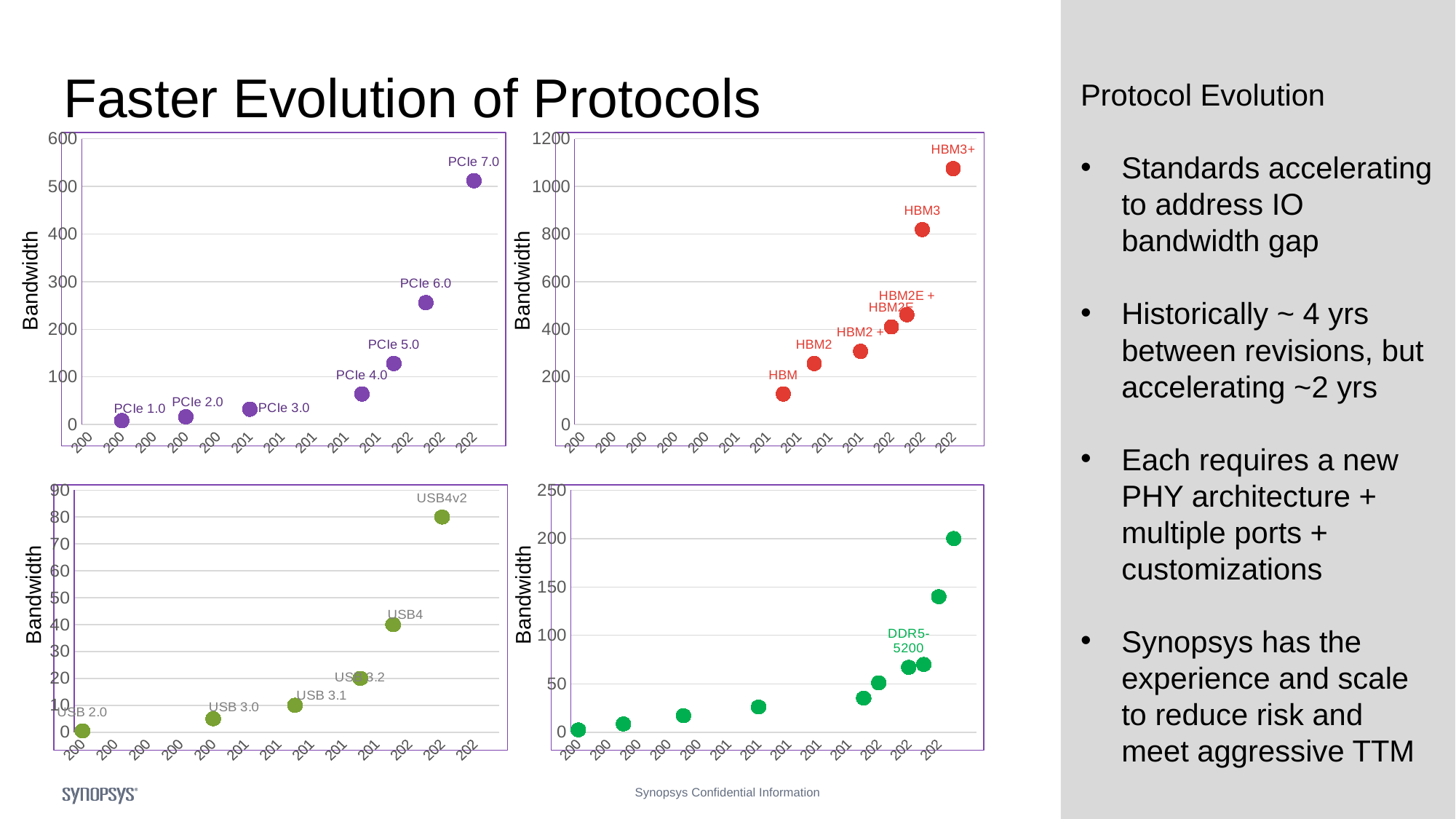
In the bottom-left USB chart, how many data points are plotted? 6 In the top-right HBM chart, is the value for HBM3+ greater or less than 1000? greater In the top-left PCIe chart, is the value for PCIe 4.0 greater or less than 100? less In the bottom-left USB chart, which is larger, the value for USB4 or the value for USB 3.2? USB4 In the top-right HBM chart, which labeled point has the lowest bandwidth? HBM In the top-left PCIe chart, is the value for PCIe 6.0 greater or less than 200? greater What kind of chart is the top-left chart (PCIe)? scatter chart In the top-left PCIe chart, how many data points are plotted? 7 In the bottom-right DDR chart, do the values rise or fall along the x axis? rise In the top-right HBM chart, which labeled point has the highest bandwidth? HBM3+ In the top-left PCIe chart, which labeled point has the highest bandwidth? PCIe 7.0